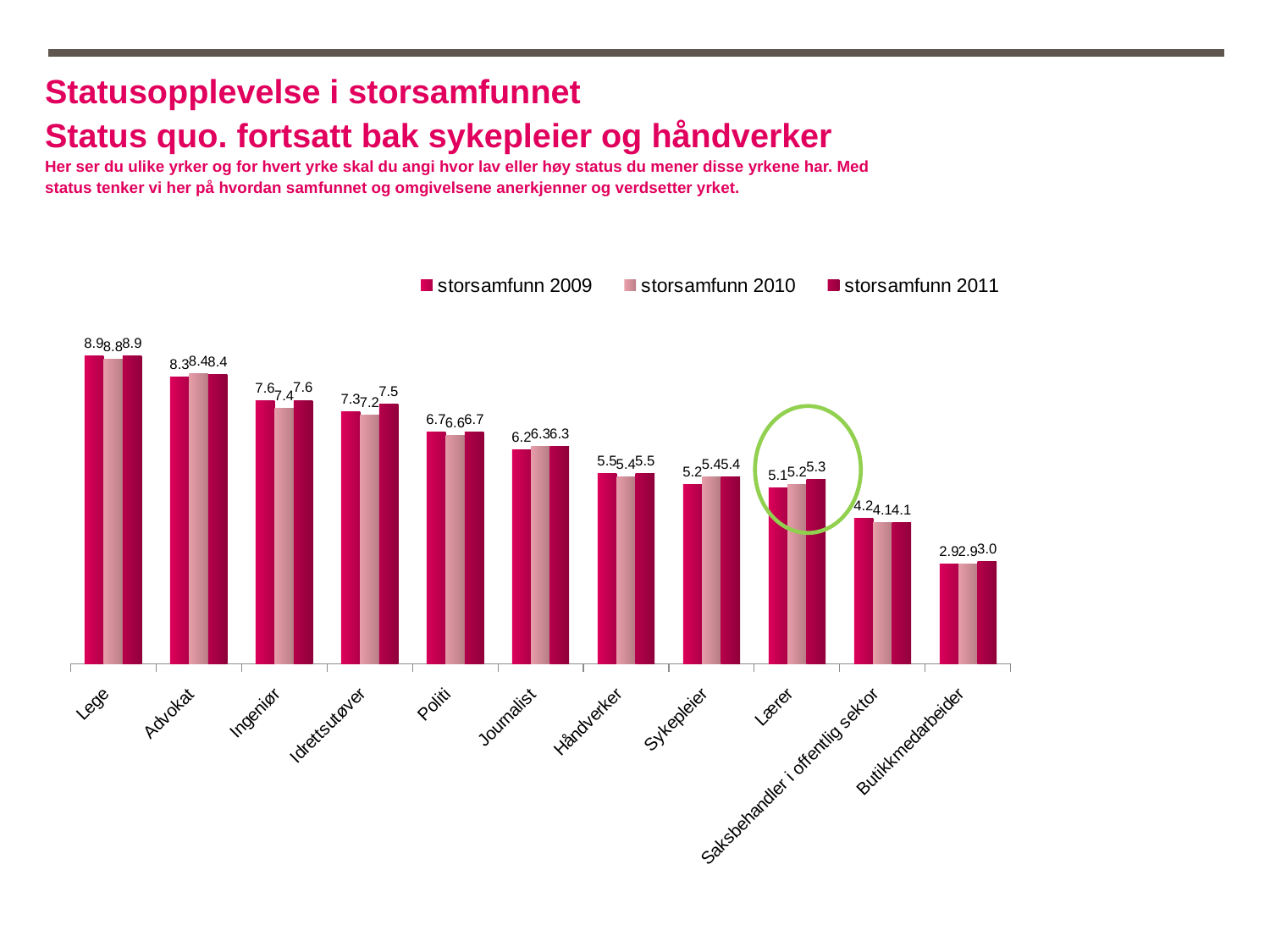
How many series does the legend list? 3 Which occupation has the lowest values across all series? Butikkmedarbeider What kind of chart is shown on the slide? bar chart Which occupation has the highest values across all series? Lege What is the value for Lærer in the storsamfunn 2011 series? 5.3 What is the value for Butikkmedarbeider in the storsamfunn 2011 series? 3.0 How many occupations (categories) are shown on the x axis? 11 Do the values generally rise or fall moving from left to right along the x axis? fall What is the value for Idrettsutøver in the storsamfunn 2011 series? 7.5 What is the difference between the storsamfunn 2011 values for Lege and Butikkmedarbeider? 5.9 What is the value for Saksbehandler i offentlig sektor in the storsamfunn 2009 series? 4.2 Which is larger in the storsamfunn 2011 series: Håndverker or Lærer? Håndverker